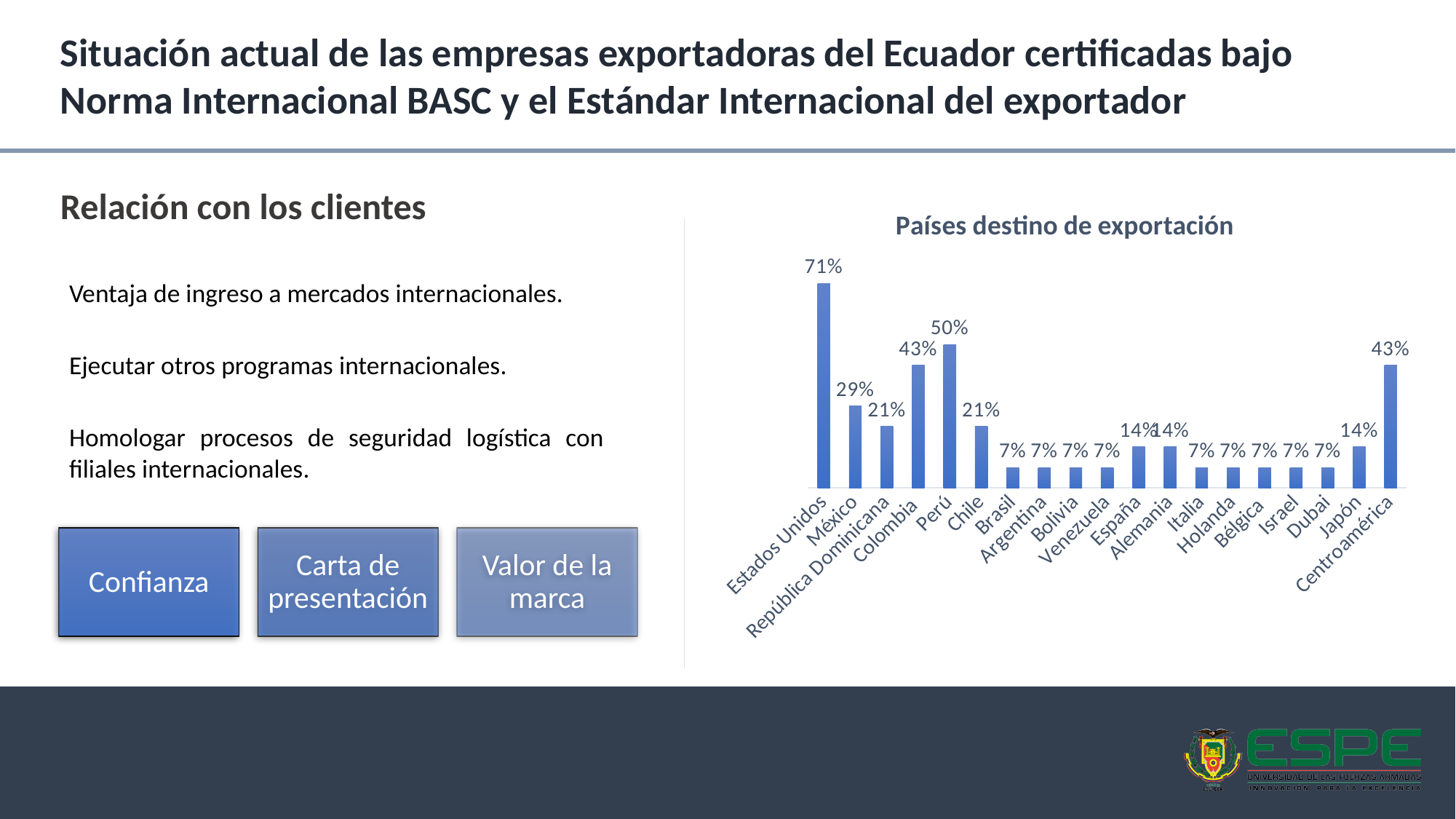
How many countries or regions are shown in the chart? 19 What is the value for México in the chart? 29% Which has a larger value, México or Colombia? Colombia Which country has the highest value in the chart? Estados Unidos What is the value for Estados Unidos in the chart? 71% What is the value for Perú in the chart? 50% What is the difference between the values for Colombia and Chile? 22% What is the title of the chart? Países destino de exportación What is the value for Centroamérica in the chart? 43% What is the difference between the values for Estados Unidos and Perú? 21% What type of chart is shown on the slide? Bar chart What is the value for Japón in the chart? 14%